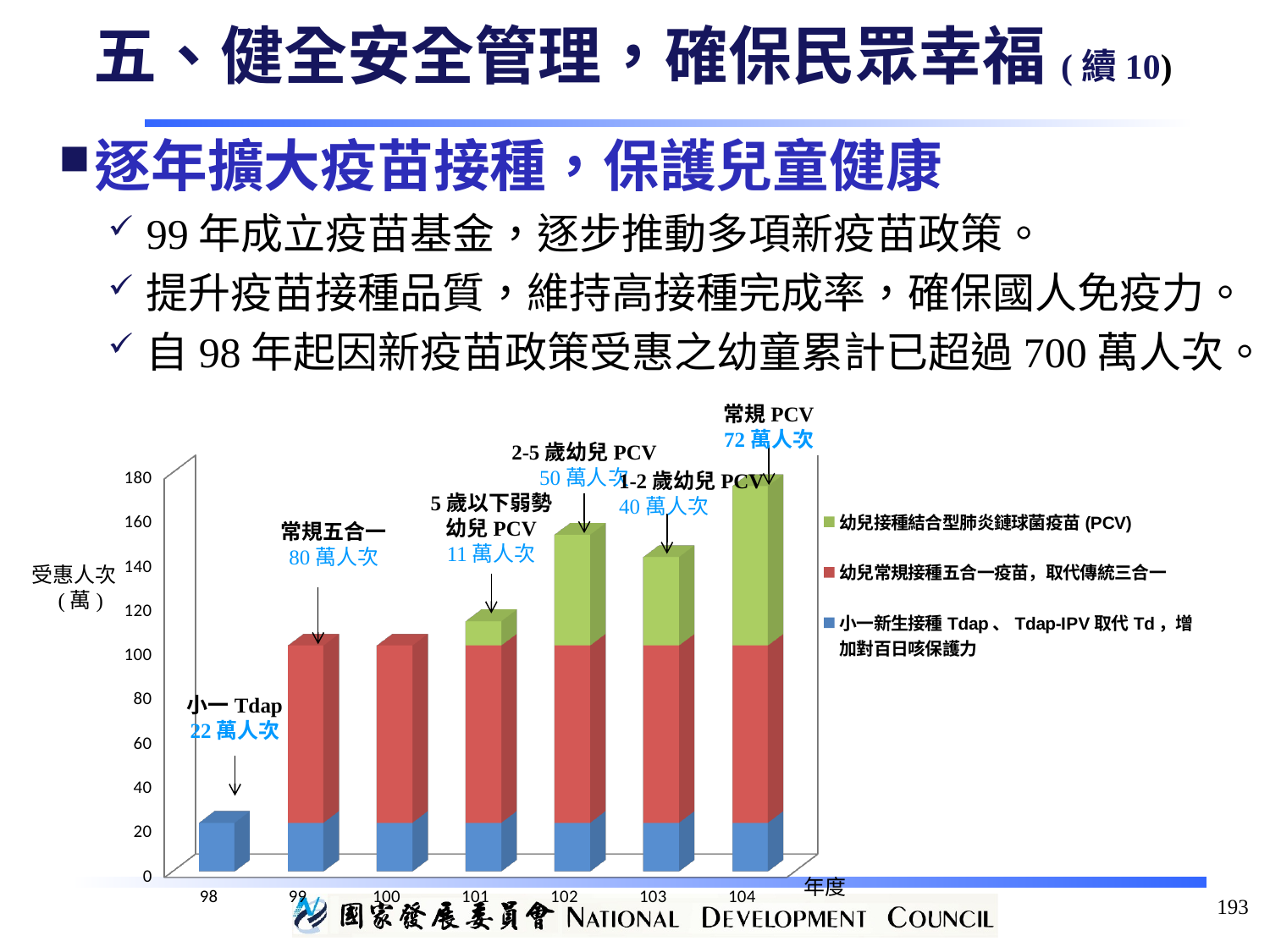
What is the difference between the annotated values for 2-5 歲幼兒 PCV (50 萬人次) and 1-2 歲幼兒 PCV (40 萬人次)? 10 萬人次 What value is annotated for 常規 PCV in year 104? 72 萬人次 What value is annotated for 5 歲以下弱勢幼兒 PCV in year 101? 11 萬人次 Which year has the shortest stacked bar? 98 Which year has the taller stacked bar, 102 or 103? 102 What kind of chart is shown on the slide? stacked bar chart Is the total bar for year 102 greater or less than 140? greater What value is annotated for 小一 Tdap in year 98? 22 萬人次 How many years (categories) are shown on the x axis? 7 What value is annotated for 常規五合一 in year 99? 80 萬人次 Which year has the tallest stacked bar? 104 How many series does the legend list? 3